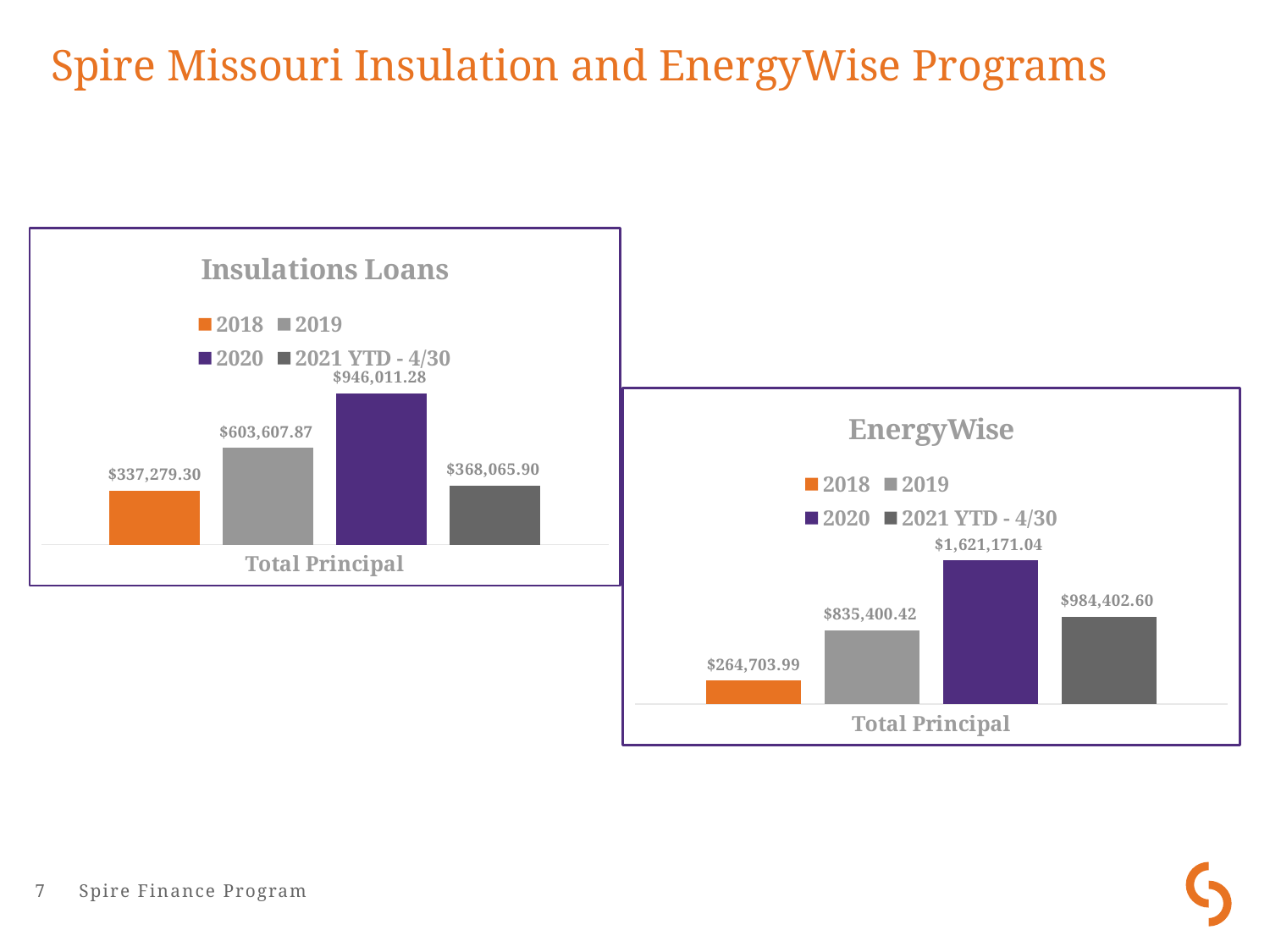
In the EnergyWise chart, what is the difference between the 2021 YTD - 4/30 and 2019 total principal? $149,002.18 What kind of chart is the Insulations Loans chart? Bar chart In the EnergyWise chart, which year has the lowest total principal? 2018 In the Insulations Loans chart, which year has the lowest total principal? 2018 In the Insulations Loans chart, which is larger: the 2018 total principal or the 2021 YTD - 4/30 total principal? 2021 YTD - 4/30 In the Insulations Loans chart, what is the total principal for 2021 YTD - 4/30? $368,065.90 In the Insulations Loans chart, what is the difference between the 2020 and 2019 total principal? $342,403.41 What colour are the 2020 bars in both charts? Purple In the Insulations Loans chart, what is the total principal for 2020? $946,011.28 How many series does the legend of the EnergyWise chart list? 4 In the EnergyWise chart, what is the total principal for 2019? $835,400.42 In the EnergyWise chart, which year has the highest total principal? 2020